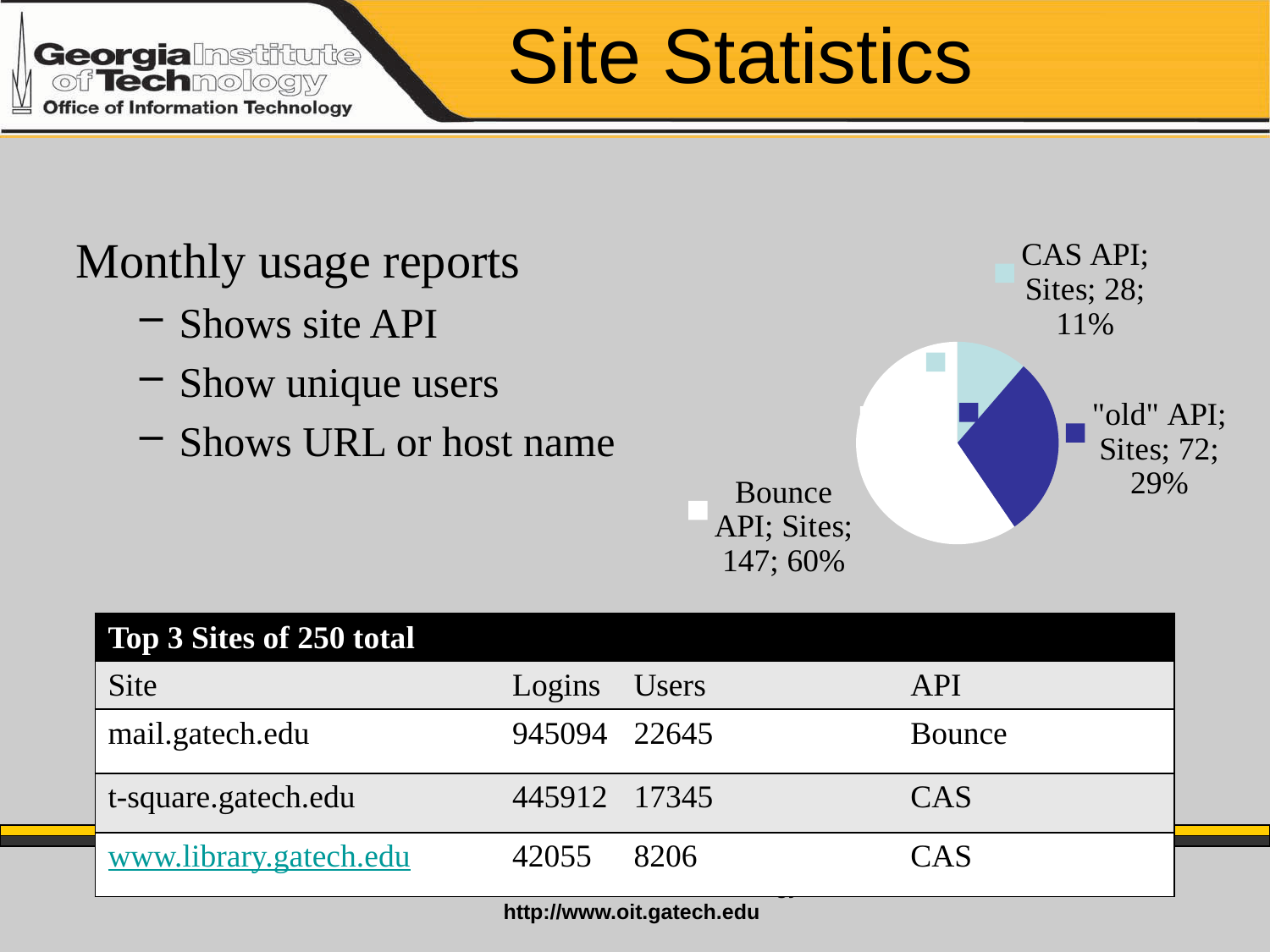
Which has more sites, the CAS API or the "old" API? "old" API What is the difference in number of sites between the Bounce API and the "old" API? 75 How many sites use the CAS API according to the pie chart? 28 How many slices does the pie chart have? 3 What share of the pie does the Bounce API slice represent? 60% What share of the pie does the "old" API slice represent? 29% How many sites use the "old" API according to the pie chart? 72 What is the total number of sites across all three slices of the pie chart? 247 What kind of chart is shown on the slide? pie chart How many sites use the Bounce API according to the pie chart? 147 Which API has the largest slice in the pie chart? Bounce API Which API has the smallest slice in the pie chart? CAS API